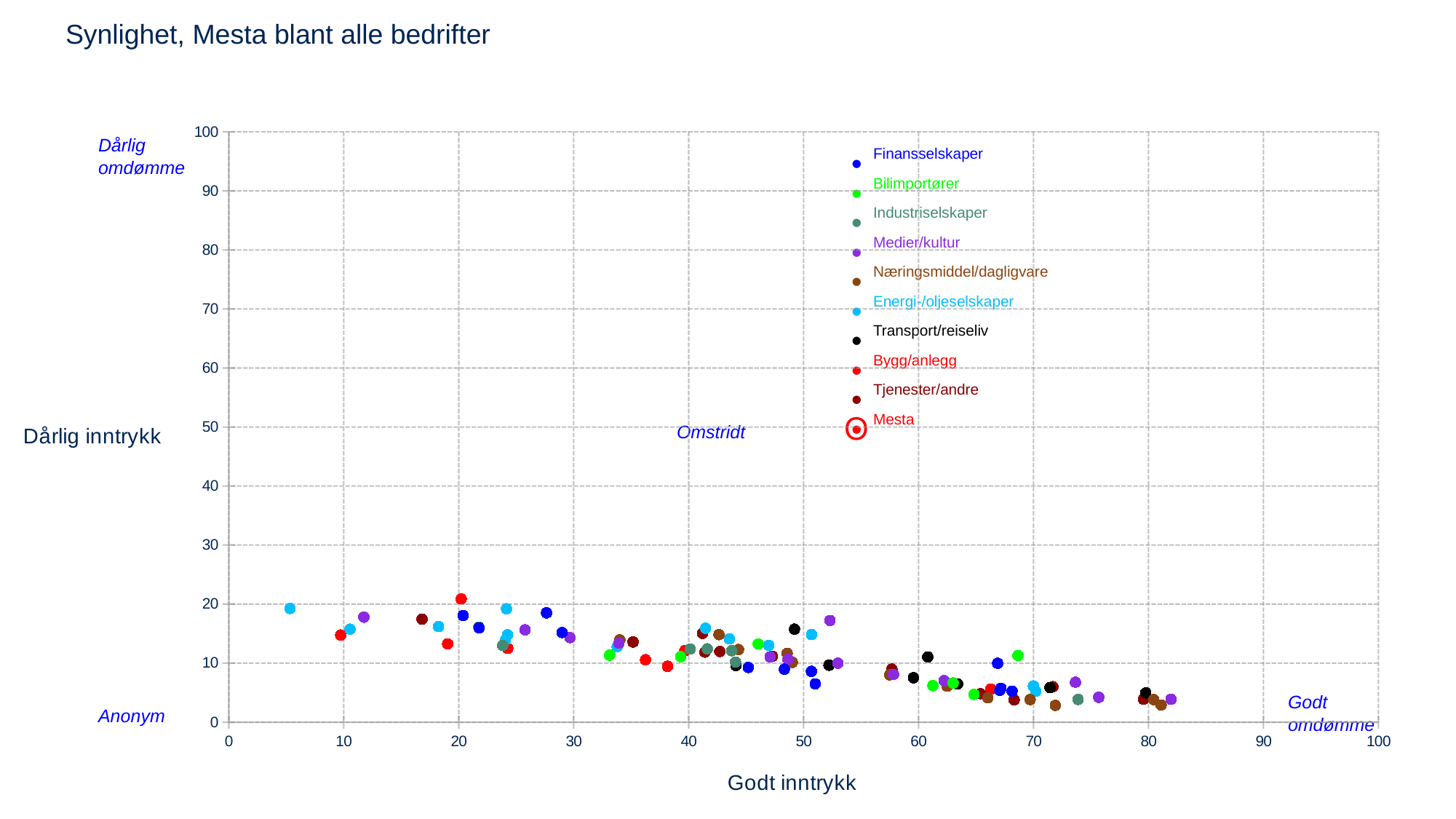
What is the highest tick value shown on the horizontal axis? 100 What is the label on the vertical axis of the chart? Dårlig inntrykk Is the horizontal-axis value of the rightmost plotted point greater or less than 80? greater What is the title of the chart? Synlighet, Mesta blant alle bedrifter Which series is listed last in the legend? Mesta Which series is listed first in the legend? Finansselskaper Is the horizontal-axis value of the leftmost plotted point greater or less than 10? less How many series does the legend list? 10 Is the vertical-axis value of the highest plotted data point (excluding the legend markers) greater or less than 30? less What is the label on the horizontal axis of the chart? Godt inntrykk What kind of chart is shown on the slide? Scatter chart What colour are the Bygg/anlegg points in the chart? Red